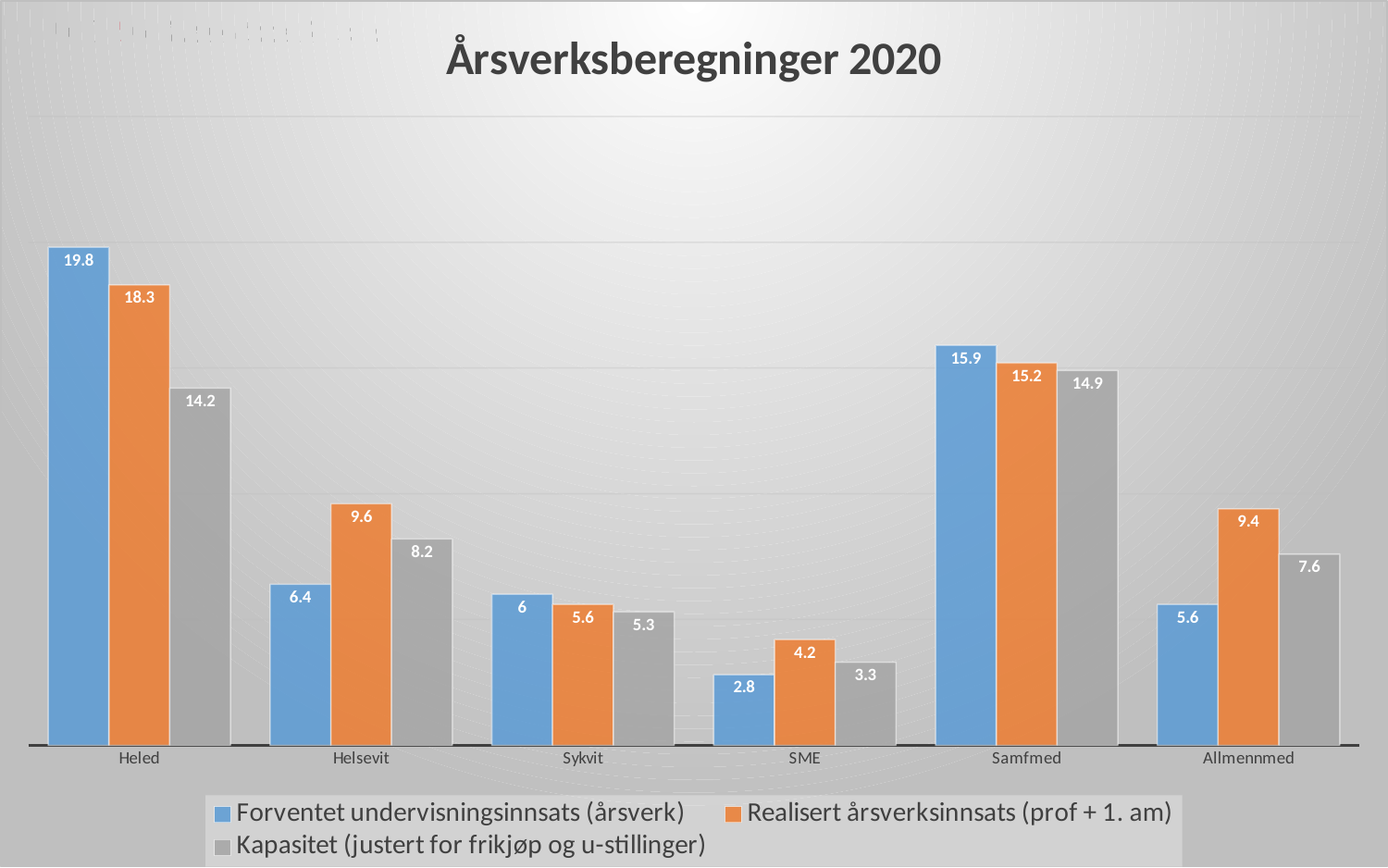
Which category has the lowest value for Kapasitet (justert for frikjøp og u-stillinger)? SME How many series does the legend list? 3 What is the value of Realisert årsverksinnsats (prof + 1. am) for Helsevit? 9.6 Which category has the highest value for Forventet undervisningsinnsats (årsverk)? Heled What is the value of Kapasitet (justert for frikjøp og u-stillinger) for Samfmed? 14.9 What is the title of the chart? Årsverksberegninger 2020 What kind of chart is shown on the slide? Bar chart What is the value of Forventet undervisningsinnsats (årsverk) for Heled? 19.8 What is the value of Forventet undervisningsinnsats (årsverk) for SME? 2.8 Which is larger for Allmennmed: Realisert årsverksinnsats (prof + 1. am) or Forventet undervisningsinnsats (årsverk)? Realisert årsverksinnsats (prof + 1. am) What is the difference between Forventet undervisningsinnsats (årsverk) and Kapasitet (justert for frikjøp og u-stillinger) for Heled? 5.6 How many categories are shown on the x axis? 6